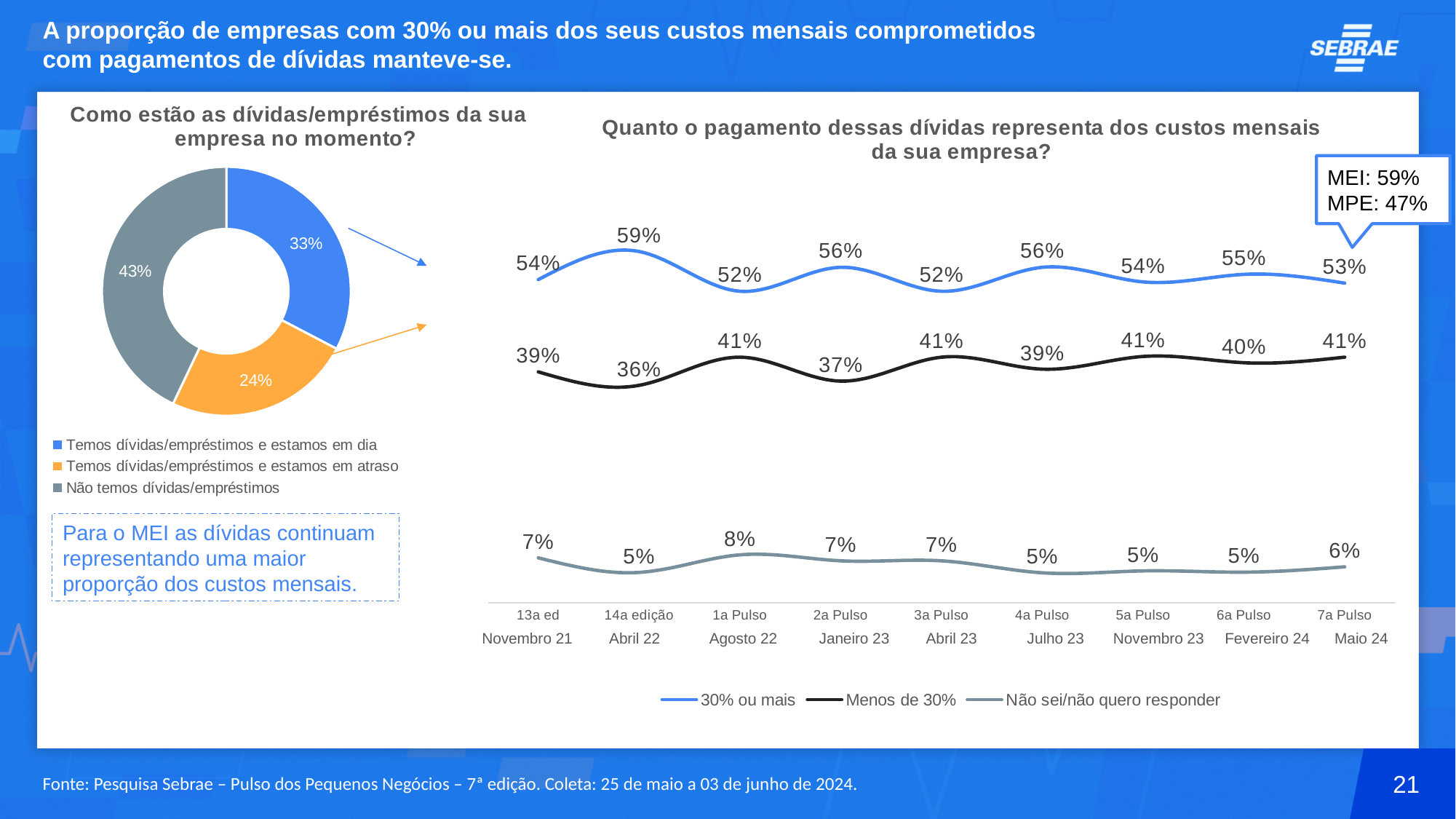
In the chart 'Quanto o pagamento dessas dívidas representa dos custos mensais da sua empresa?', what is the difference between '30% ou mais' and 'Menos de 30%' at 1a Pulso Agosto 22? 11 percentage points In the chart 'Quanto o pagamento dessas dívidas representa dos custos mensais da sua empresa?', what is the highest value of 'Não sei/não quero responder'? 8% In the chart 'Como estão as dívidas/empréstimos da sua empresa no momento?', what share is 'Não temos dívidas/empréstimos'? 43% In the chart 'Quanto o pagamento dessas dívidas representa dos custos mensais da sua empresa?', how many series does the legend list? 3 In the chart 'Quanto o pagamento dessas dívidas representa dos custos mensais da sua empresa?', at which edition does '30% ou mais' reach its highest value? 14a edição Abril 22 In the chart 'Como estão as dívidas/empréstimos da sua empresa no momento?', which category has the largest slice? Não temos dívidas/empréstimos In the chart 'Como estão as dívidas/empréstimos da sua empresa no momento?', what is the value for 'Temos dívidas/empréstimos e estamos em atraso'? 24% In the chart 'Quanto o pagamento dessas dívidas representa dos custos mensais da sua empresa?', what is the value of 'Menos de 30%' for 14a edição Abril 22? 36% In the chart 'Quanto o pagamento dessas dívidas representa dos custos mensais da sua empresa?', which is larger at 3a Pulso Abril 23: '30% ou mais' or 'Menos de 30%'? 30% ou mais What kind of chart is 'Como estão as dívidas/empréstimos da sua empresa no momento?'? Doughnut (pie) chart In the chart 'Quanto o pagamento dessas dívidas representa dos custos mensais da sua empresa?', what is the value of '30% ou mais' for 7a Pulso Maio 24? 53% In the chart 'Quanto o pagamento dessas dívidas representa dos custos mensais da sua empresa?', how many editions are shown on the x axis? 9